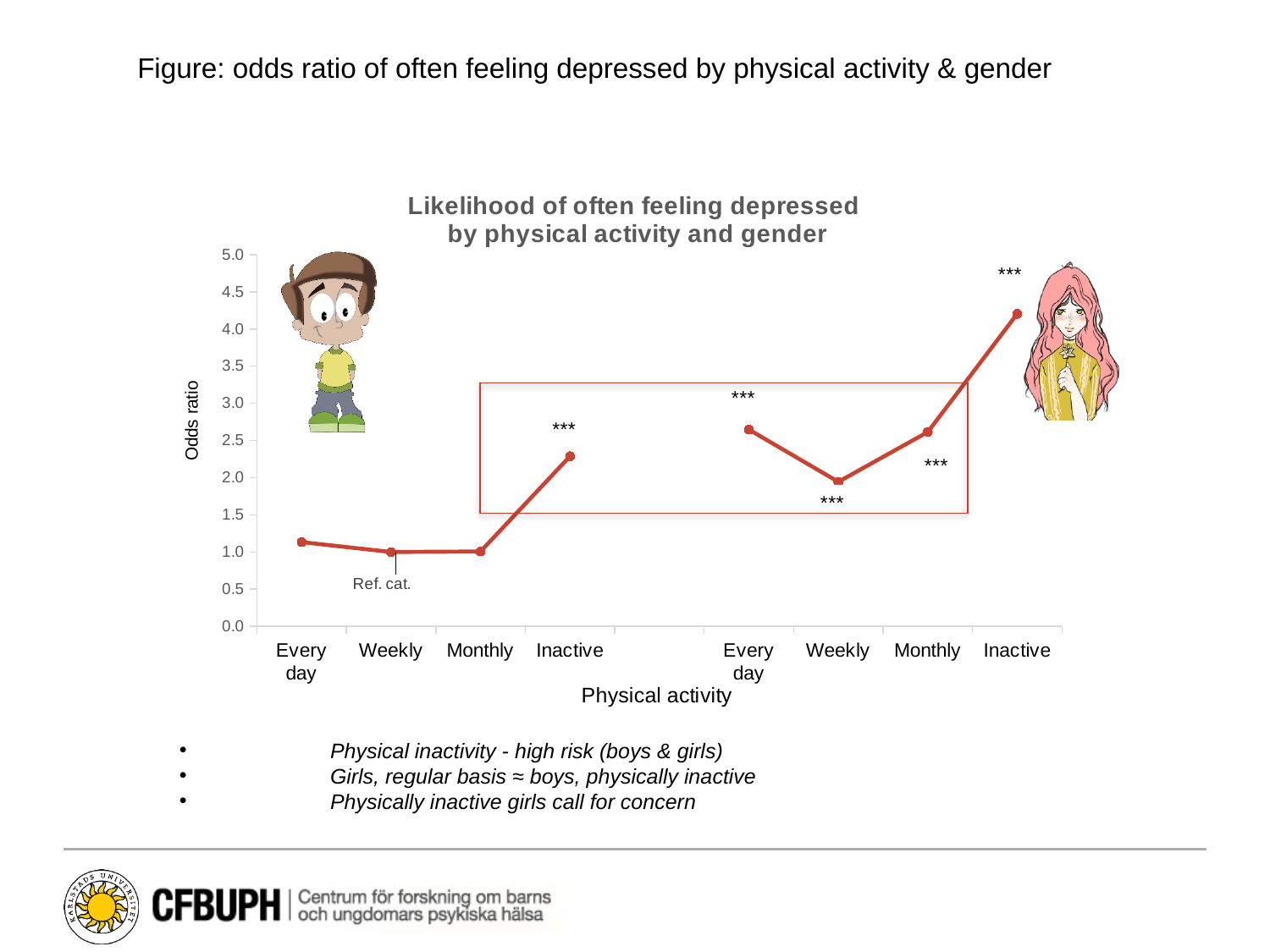
Is the odds ratio for Inactive in the left group greater or less than 2.0? greater What is the odds ratio for the Weekly category in the left group, marked as the reference category? 1.0 Is the odds ratio for Every day in the left group greater or less than 1.5? less Is the odds ratio for Every day in the right group greater or less than 2.5? greater How many categories are labelled along the x axis? 8 What kind of chart is shown on the slide? line chart What is the title of the chart? Likelihood of often feeling depressed by physical activity and gender In the left group, does the odds ratio rise or fall from Monthly to Inactive? rise Which category has the highest odds ratio on the chart? Inactive (right group) What is the label of the vertical axis? Odds ratio Which is larger, the odds ratio for Inactive in the left group or Inactive in the right group? Inactive in the right group